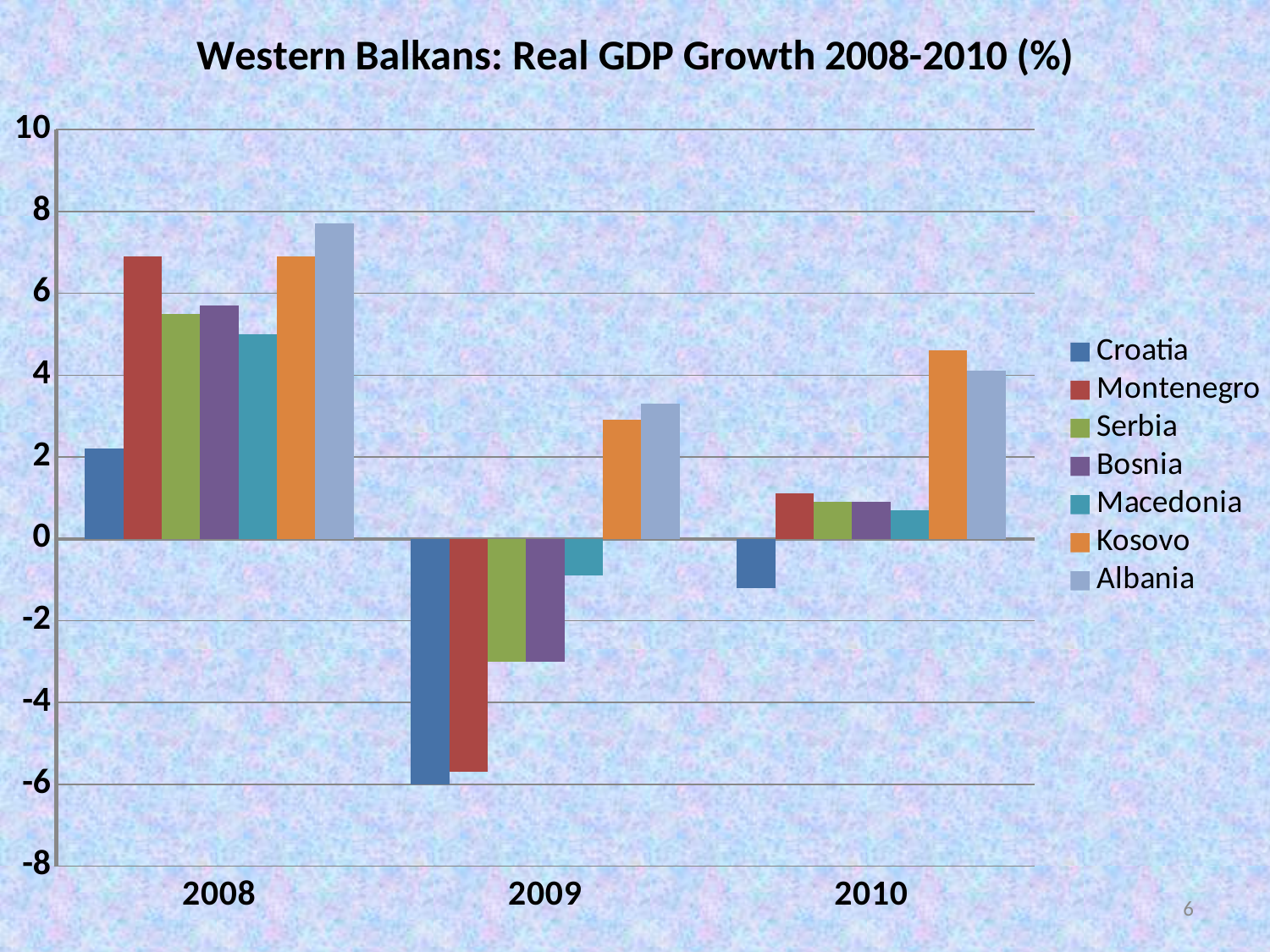
How many years are shown on the x axis? 3 How many countries show positive real GDP growth in 2009? 2 Which country had the lowest real GDP growth in 2010? Croatia How many series does the legend list? 7 Is the value for Croatia in 2009 greater or less than -4? less What is the title of the chart? Western Balkans: Real GDP Growth 2008-2010 (%) What kind of chart is shown on the slide? bar chart In 2008, which had higher real GDP growth, Croatia or Montenegro? Montenegro Which country had the highest real GDP growth in 2008? Albania Which country had the highest real GDP growth in 2010? Kosovo Is the value for Kosovo in 2010 greater or less than 4? greater Is the value for Albania in 2008 greater or less than 6? greater